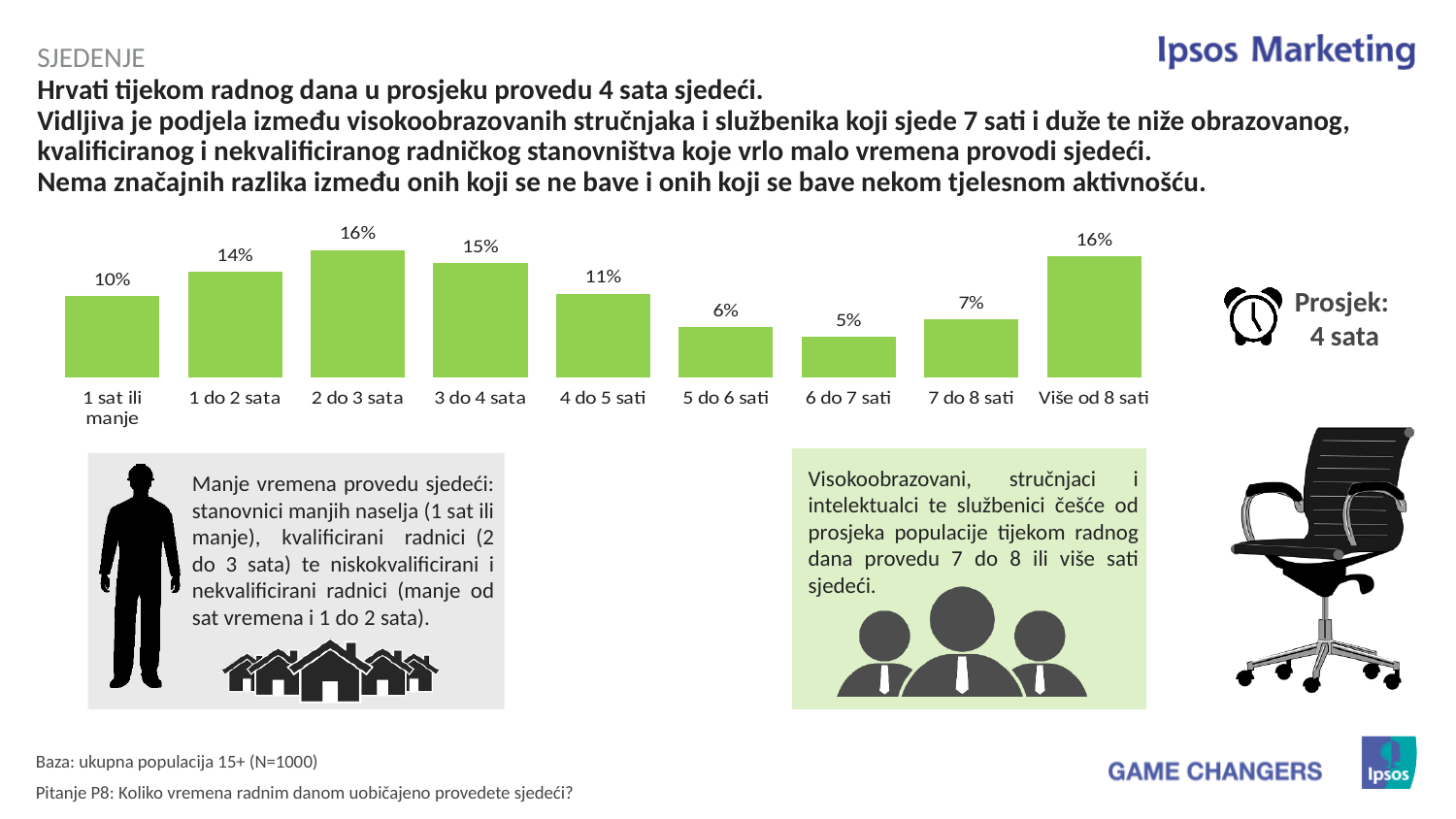
What is the difference between the values for 4 do 5 sati and 5 do 6 sati? 5% What is the difference between the values for 2 do 3 sata and 1 sat ili manje? 6% What average (Prosjek) is stated next to the chart? 4 sata How many categories are shown in the chart? 9 Which is larger, the value for 4 do 5 sati or the value for 3 do 4 sata? 3 do 4 sata What percentage of respondents sit 1 sat ili manje during a working day? 10% What kind of chart is shown on the slide? Bar chart What is the value shown for 6 do 7 sati? 5% What is the value shown for the category 3 do 4 sata? 15% Which category has the lowest value in the chart? 6 do 7 sati Which is larger, the value for 1 do 2 sata or the value for 7 do 8 sati? 1 do 2 sata What is the value shown for Više od 8 sati? 16%